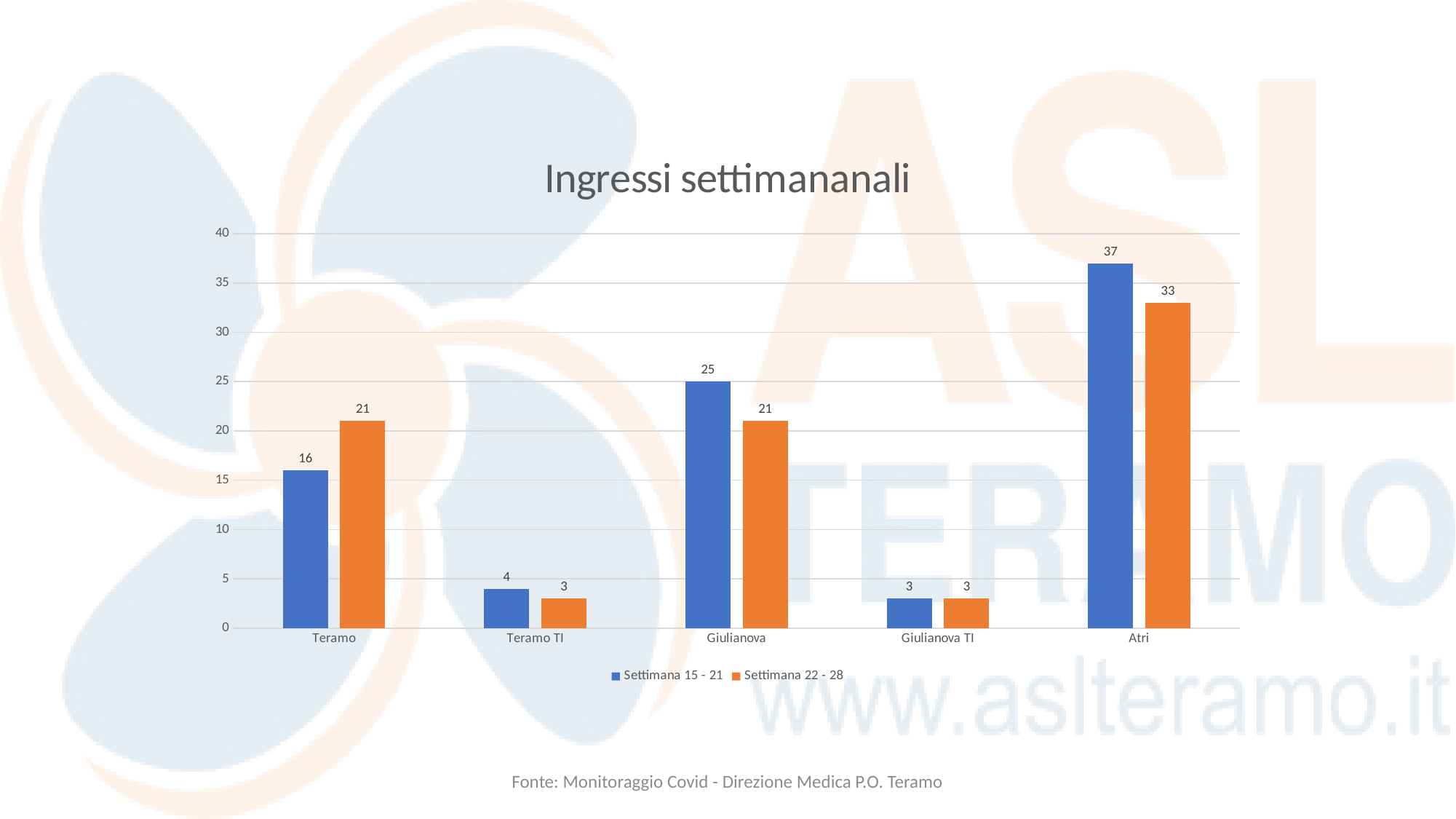
What is the difference between the Settimana 15 - 21 and Settimana 22 - 28 values for Atri? 4 How many series does the legend list? 2 How many categories are shown on the x axis? 5 What is the title of the chart? Ingressi settimananali What is the value for Teramo in the Settimana 15 - 21 series? 16 What is the value for Atri in the Settimana 22 - 28 series? 33 Which is larger for Teramo: the Settimana 15 - 21 value or the Settimana 22 - 28 value? Settimana 22 - 28 What is the value for Giulianova in the Settimana 22 - 28 series? 21 Which category has the highest value in the Settimana 15 - 21 series? Atri What colour represents the Settimana 22 - 28 series? Orange What kind of chart is shown on the slide? Bar chart Which category has the lowest value in the Settimana 22 - 28 series? Teramo TI and Giulianova TI (both 3)